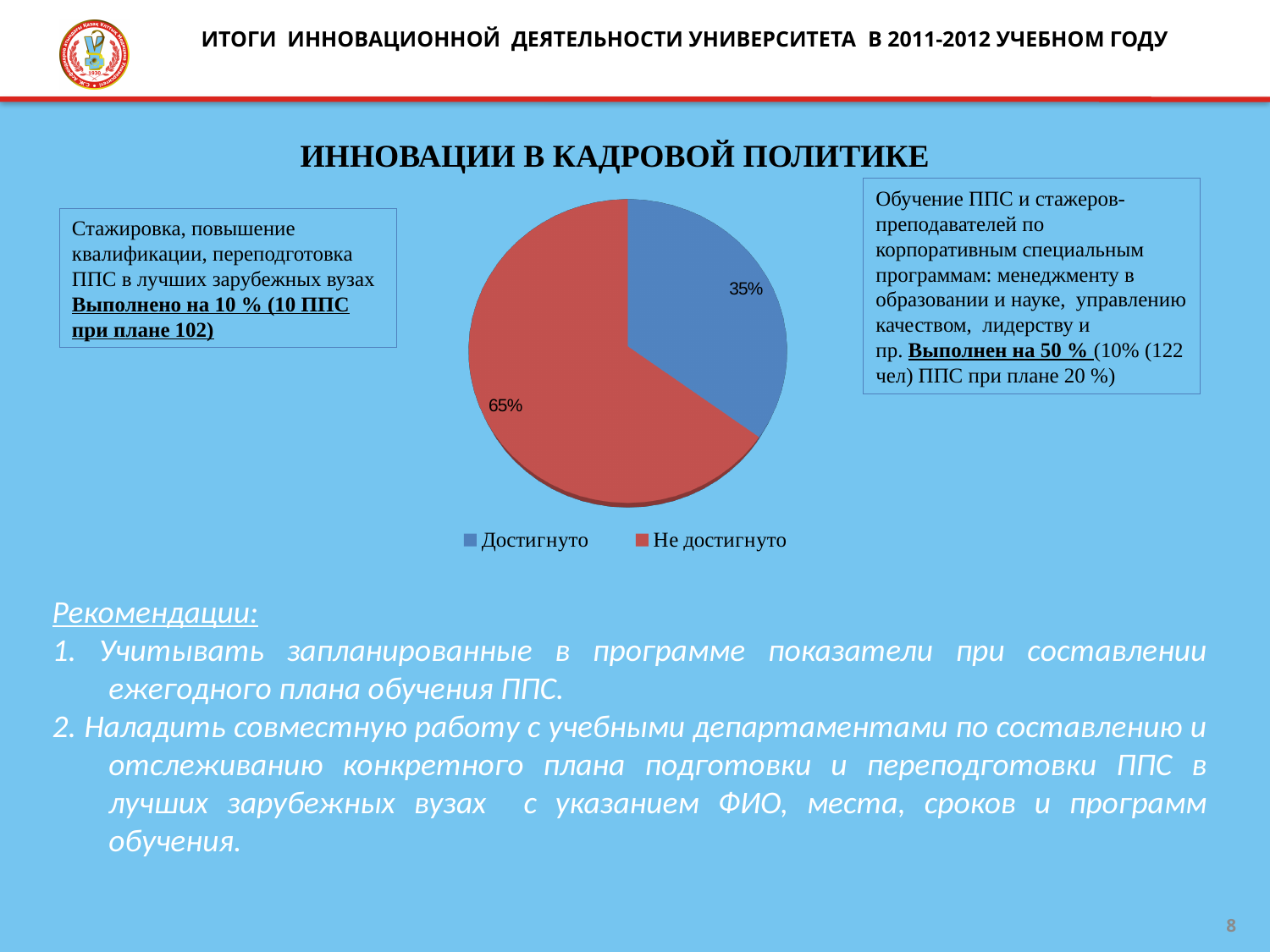
What share of the pie does "Достигнуто" represent? 35% How many slices does the pie chart have? 2 What share of the pie does "Не достигнуто" represent? 65% What colour is the "Не достигнуто" slice? red Which is larger, the "Достигнуто" slice or the "Не достигнуто" slice? Не достигнуто What kind of chart is shown on the slide? pie chart Which slice of the pie is the largest? Не достигнуто Which slice of the pie is the smallest? Достигнуто How many entries does the legend list? 2 What colour is the "Достигнуто" slice? blue What is the difference in percentage points between the "Не достигнуто" and "Достигнуто" slices? 30